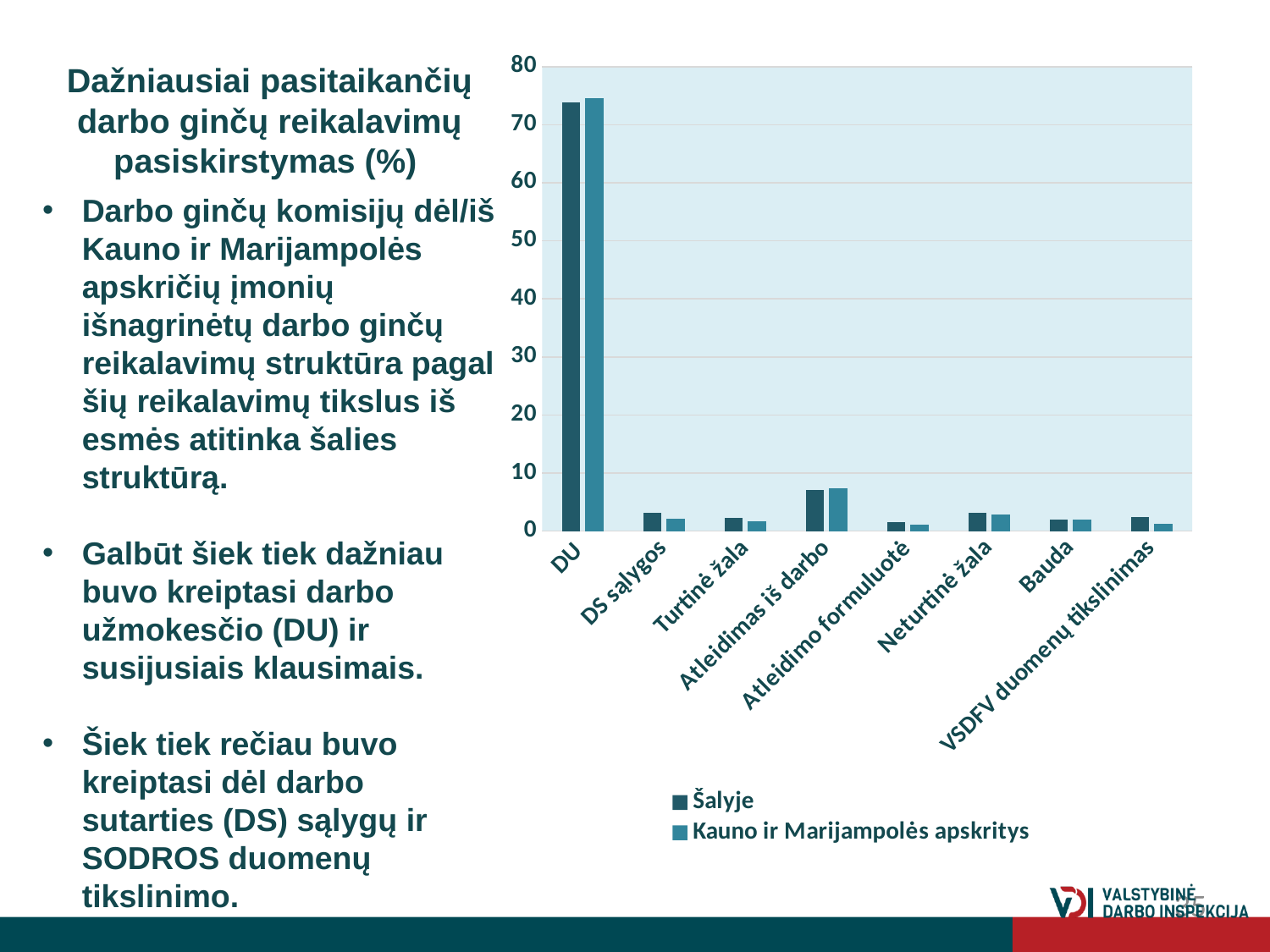
Is the Šalyje value for DU greater or less than 70? greater How many categories are shown on the x axis of the chart? 8 Which is larger for the Šalyje series: DU or Atleidimas iš darbo? DU What is the title of the chart on the slide? Dažniausiai pasitaikančių darbo ginčų reikalavimų pasiskirstymas (%) Which category has the highest value for the Kauno ir Marijampolės apskritys series? DU What are the two series named in the chart legend? Šalyje; Kauno ir Marijampolės apskritys Is the Šalyje value for DS sąlygos greater or less than 10? less Which is larger for the Kauno ir Marijampolės apskritys series: Atleidimas iš darbo or Bauda? Atleidimas iš darbo Is the Kauno ir Marijampolės apskritys value for Atleidimas iš darbo greater or less than 10? less Which category has the highest value for the Šalyje series? DU How many series does the chart legend list? 2 What kind of chart is shown on the slide? bar chart